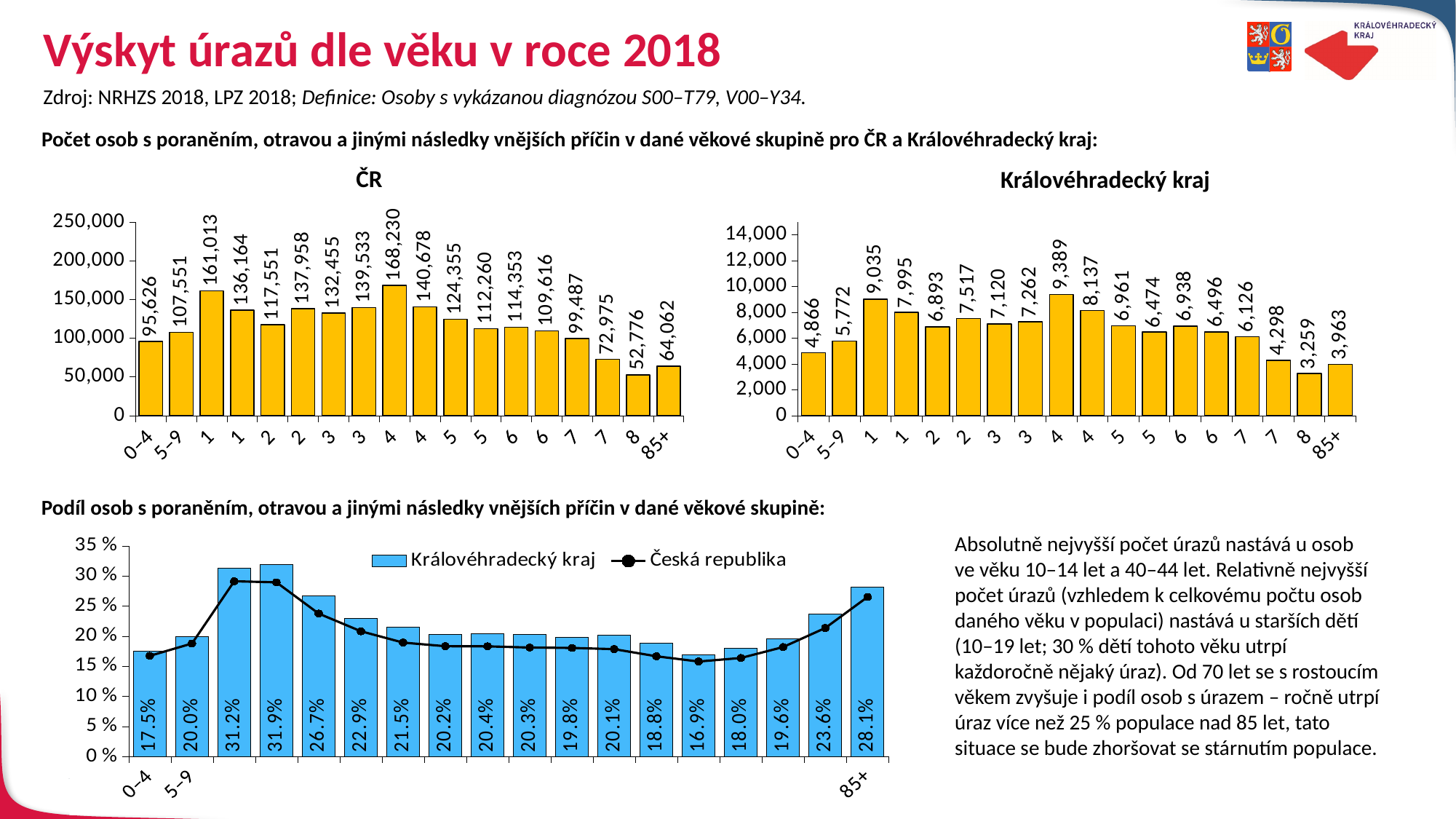
How many series does the legend of the bottom chart (Podíl osob s poraněním) list? 2 In the Královéhradecký kraj chart, which age group has the larger value, 0–4 or 85+? 0–4 In the ČR chart, what is the value for the 85+ age group? 64,062 In the bottom chart (Podíl osob s poraněním), is the Česká republika value for the 85+ age group greater or less than 25 %? greater How many bars are plotted in the ČR chart? 18 In the ČR chart, what is the value of the tallest bar? 168,230 In the bottom chart (Podíl osob s poraněním), what is the Královéhradecký kraj value for the 85+ age group? 28.1% In the Královéhradecký kraj chart, what is the value of the shortest bar? 3,259 In the Královéhradecký kraj chart, what is the value for the 85+ age group? 3,963 In the Královéhradecký kraj chart, what is the value for the 5–9 age group? 5,772 In the ČR chart, what is the value for the 0–4 age group? 95,626 In the ČR chart, what is the difference between the values for the 5–9 and 0–4 age groups? 11,925